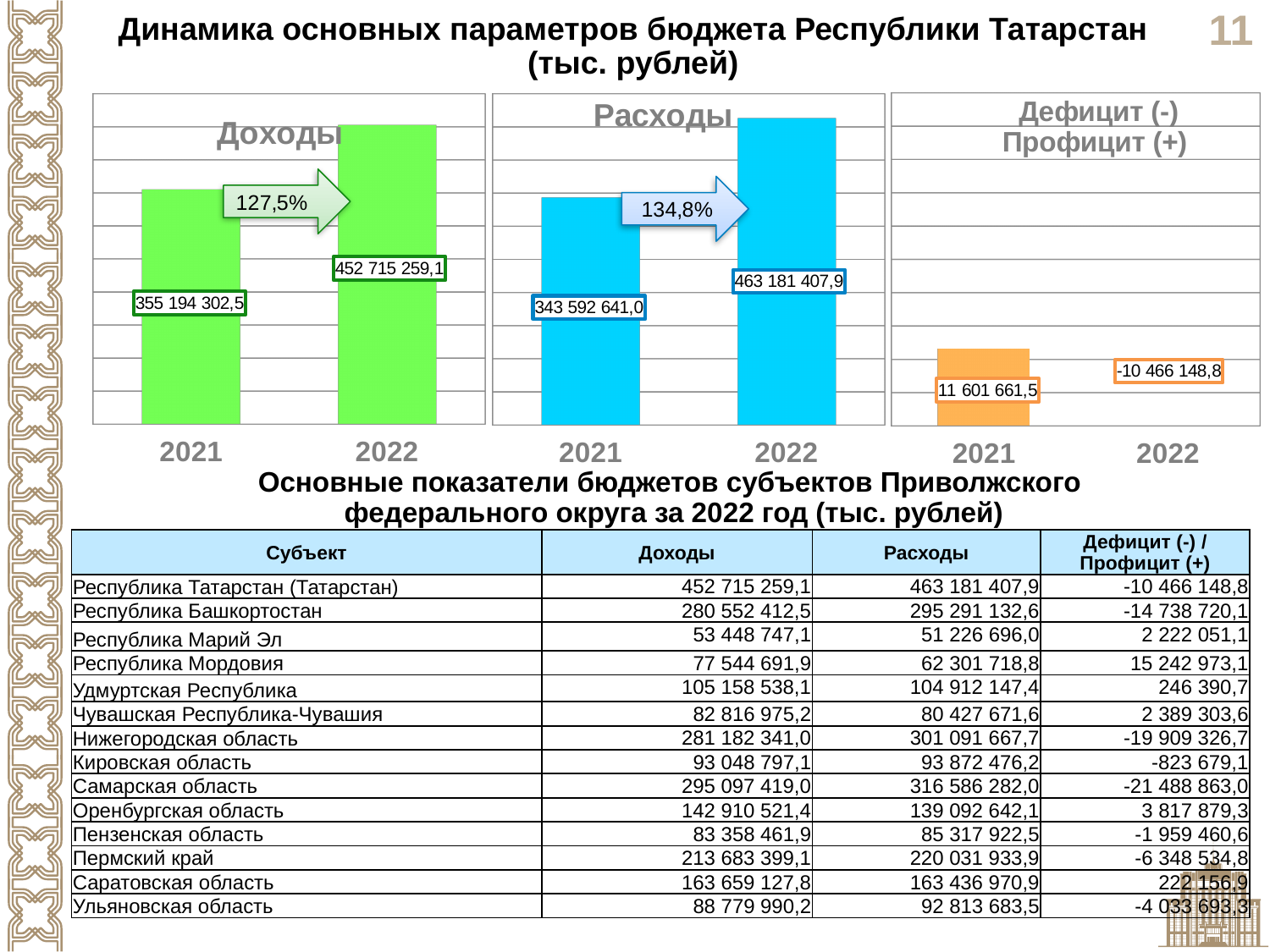
In the "Доходы" chart, what is the value for 2021? 355 194 302,5 In the "Дефицит (-) Профицит (+)" chart, what is the value for 2021? 11 601 661,5 In the "Расходы" chart, what is the value for 2022? 463 181 407,9 What percentage is shown on the arrow in the "Расходы" chart? 134,8% What type of chart is the "Доходы" chart? Bar chart In the "Дефицит (-) Профицит (+)" chart, what is the value for 2022? -10 466 148,8 In the "Расходы" chart, what is the value for 2021? 343 592 641,0 In the "Доходы" chart, what is the value for 2022? 452 715 259,1 In the "Расходы" chart, which year has the higher value, 2021 or 2022? 2022 In the "Доходы" chart, by how much does the 2022 value exceed the 2021 value? 97 520 956,6 In the "Расходы" chart, what is the difference between the 2022 and 2021 values? 119 588 766,9 In the "Дефицит (-) Профицит (+)" chart, which year has the lower value? 2022